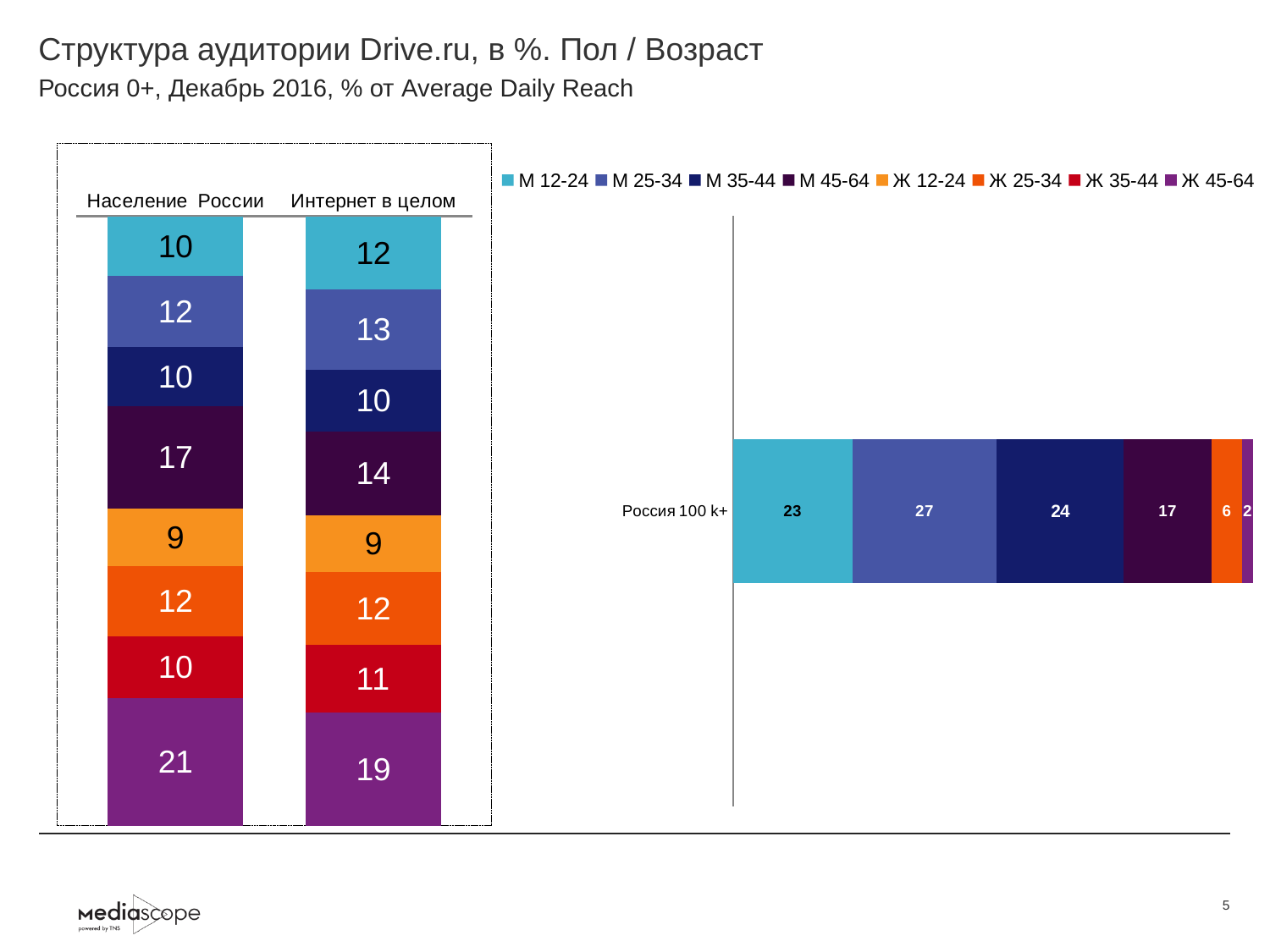
In the right chart, what is the value of the М 12-24 segment for Россия 100 k+? 23 In the right chart, what is the value of the М 25-34 segment for Россия 100 k+? 27 In the left chart, which segment is the smallest in the Интернет в целом bar? Ж 12-24 In the left chart, which is larger: the М 12-24 value for Население России or for Интернет в целом? Интернет в целом In the left chart, what is the value of the М 45-64 segment for Население России? 17 How many series does the legend on the right chart list? 8 In the left chart, what is the value of the Ж 45-64 segment for Интернет в целом? 19 In the left chart, what is the value of the М 25-34 segment for Интернет в целом? 13 How many bars does the left chart show? 2 What type of chart is shown on the right side of the slide? Stacked bar chart In the left chart, what is the difference between the М 45-64 values for Население России and Интернет в целом? 3 In the left chart, which segment is the largest in the Население России bar? Ж 45-64